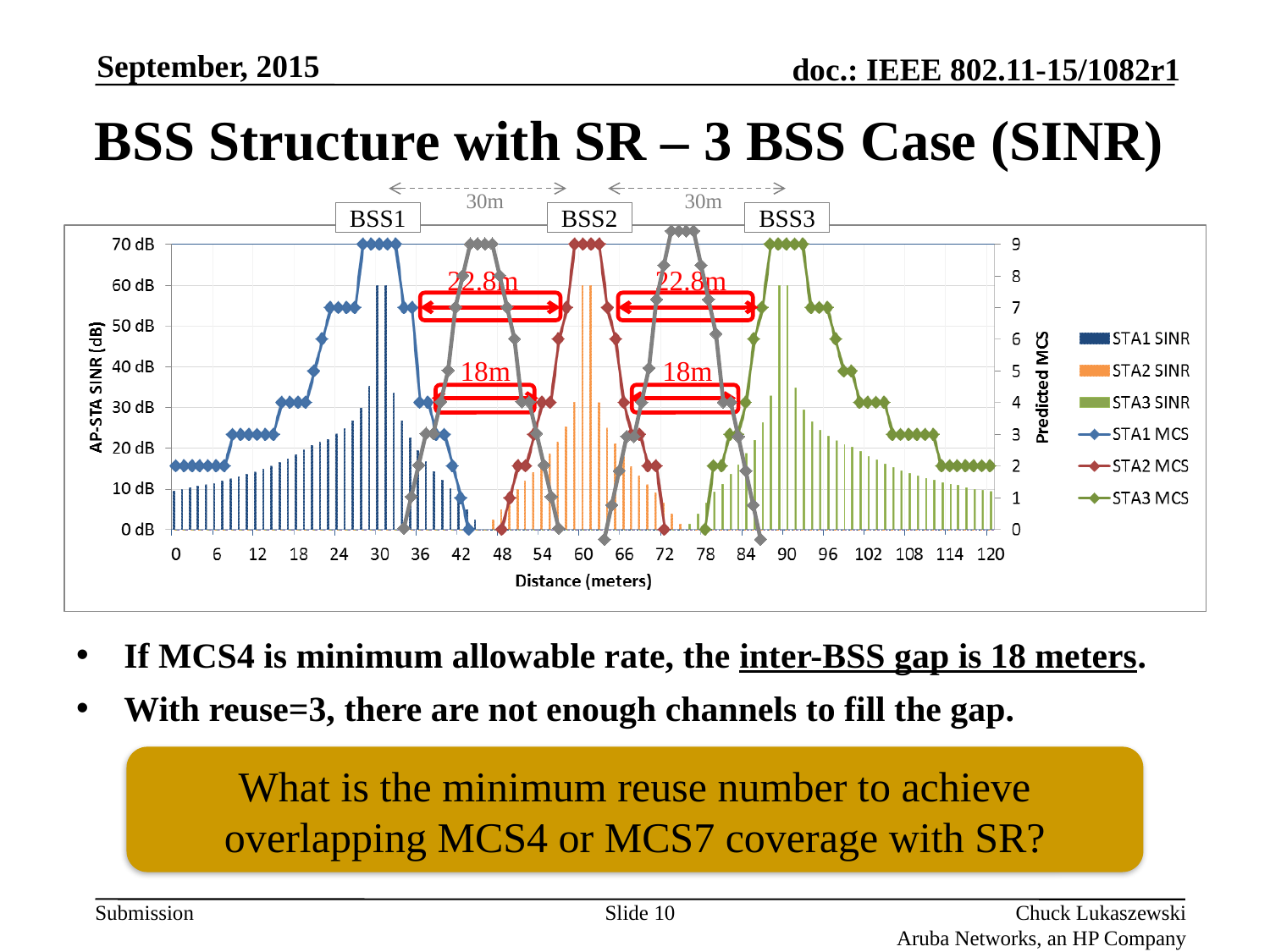
What is the title of the right-hand y axis of the chart? Predicted MCS What is the Predicted MCS value of the STA1 MCS line at a distance of 0 meters? 2 What is the Predicted MCS value of the STA3 MCS line at a distance of 120 meters? 2 What is the title of the x axis of the chart? Distance (meters) What kind of chart is shown on the slide? Combined bar and line chart What is the highest Predicted MCS value reached by the STA1 MCS line? 9 Is the STA1 SINR value at 30 meters greater or less than 50 dB? greater Does the STA3 MCS line rise or fall as distance increases from 90 to 120 meters? Fall Is the STA2 SINR value at 60 meters greater or less than 50 dB? greater Is the STA1 SINR value at 0 meters greater or less than 20 dB? less How many series does the chart legend list? 6 Which is larger, the STA1 SINR value at 30 meters or the STA1 SINR value at 0 meters? STA1 SINR at 30 meters